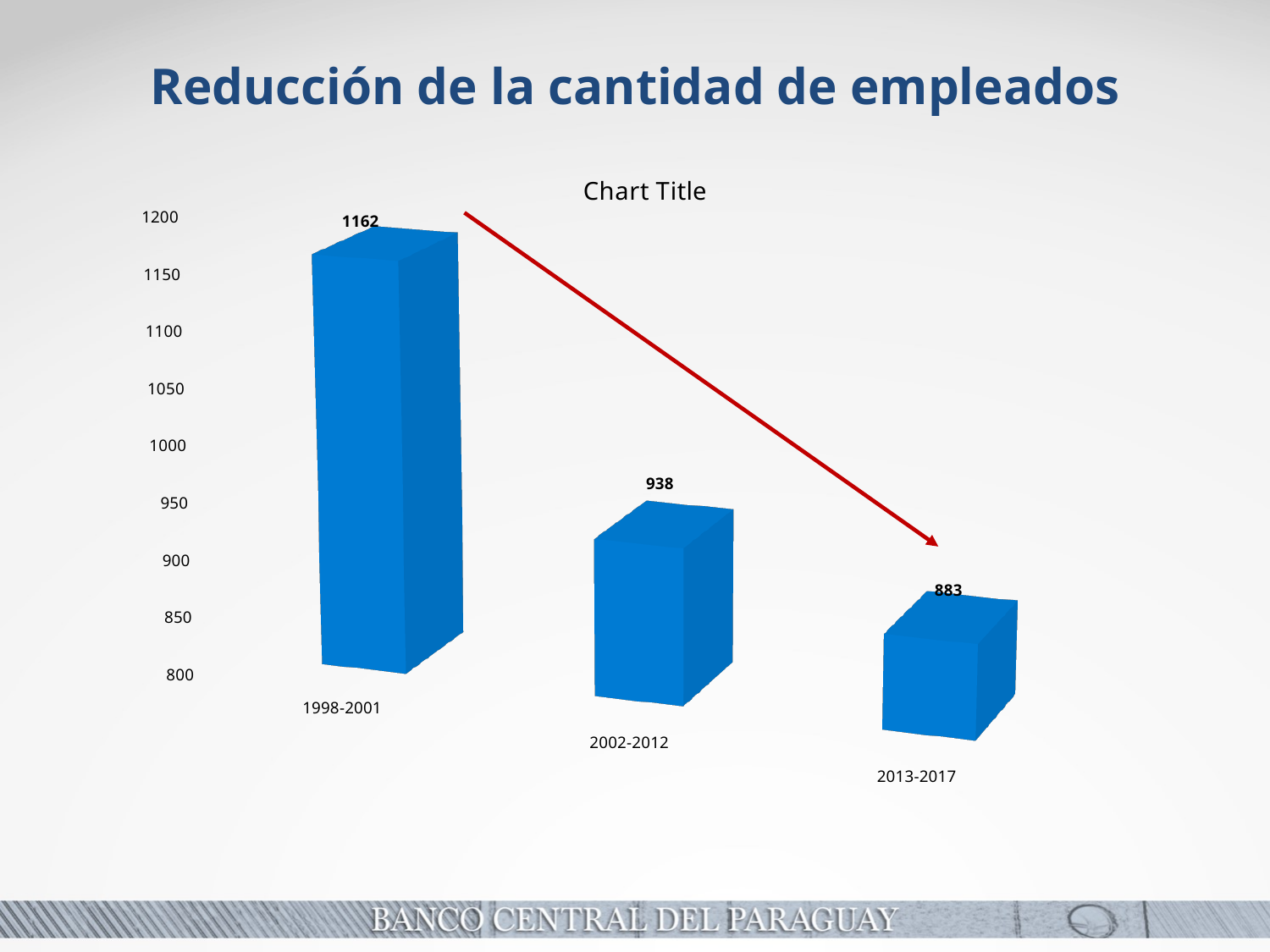
What kind of chart is shown on the slide? bar chart How many periods are shown on the chart? 3 What is the value for 2002-2012? 938 What is the difference between the values for 1998-2001 and 2013-2017? 279 Is the value for 2002-2012 greater or less than 1000? less What is the value for 2013-2017? 883 Which period has the highest value? 1998-2001 Which is larger, the value for 2002-2012 or the value for 2013-2017? 2002-2012 Which period has the lowest value? 2013-2017 What is the value for 1998-2001? 1162 Do the values rise or fall from 1998-2001 to 2013-2017? fall What is the difference between the values for 2002-2012 and 2013-2017? 55